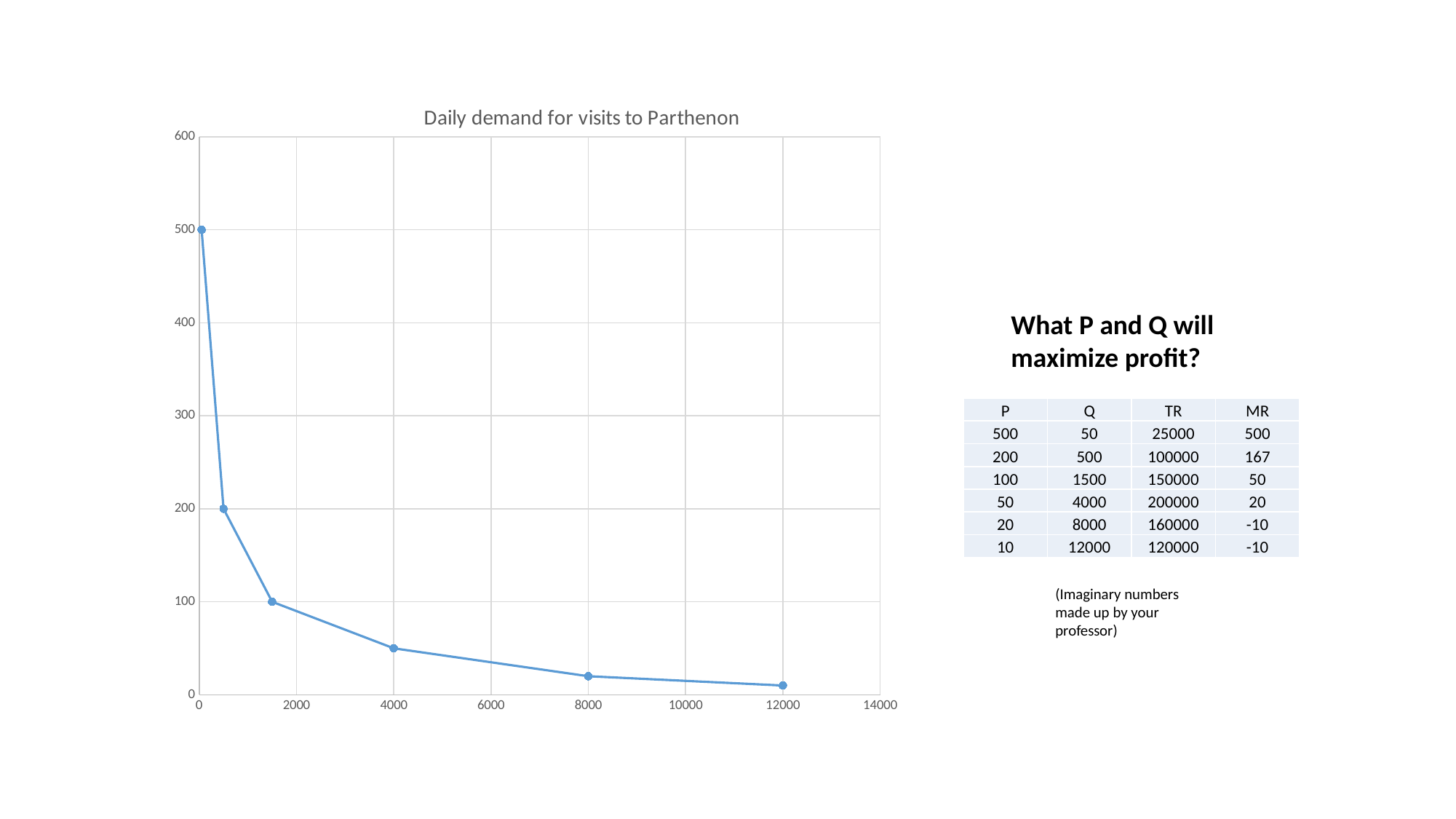
Which is larger: the price at quantity 1500 or the price at quantity 4000? the price at quantity 1500 Does the plotted line rise or fall as quantity increases along the x axis? fall What is the price (y value) at a quantity of 12000? 10 What is the price (y value) at a quantity of 4000? 50 What is the price (y value) at a quantity of 8000? 20 Is the price at quantity 1500 greater or less than 200? less What is the lowest price value plotted on the chart? 10 What is the title of the chart? Daily demand for visits to Parthenon How many data points are plotted on the chart? 6 What is the difference between the price at quantity 4000 and the price at quantity 8000? 30 What kind of chart is shown on the slide? line chart What is the highest price value plotted on the chart? 500